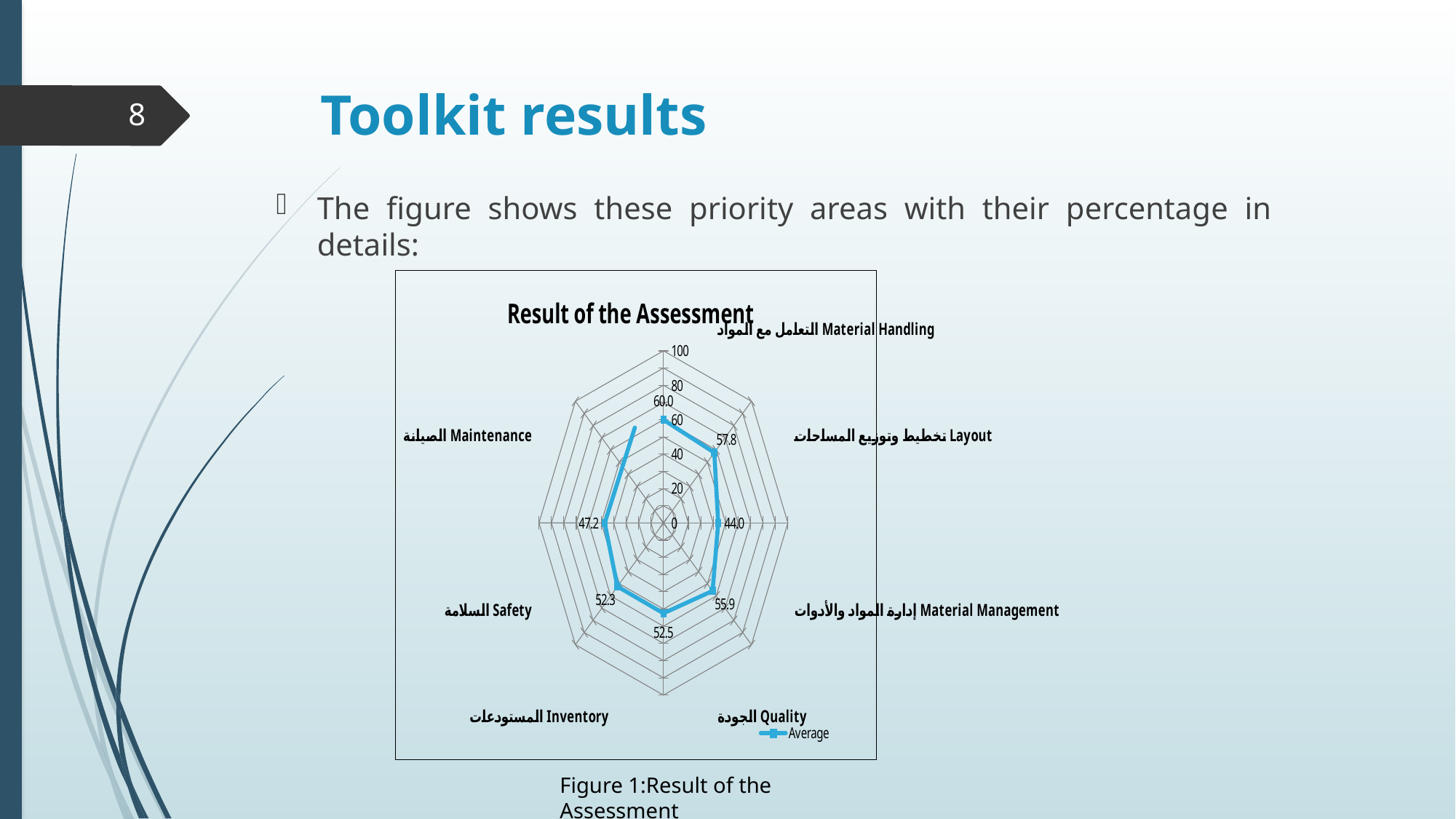
What is the value for Layout? 57.8 What kind of chart is shown on the slide? radar chart What is the difference between the values for Material Handling and Layout? 2.2 Is the value for Material Handling greater or less than 40? greater Which is larger, the value for Material Handling or the value for Material Management? Material Handling What is the value for Material Management? 44.0 What is the value for Material Handling? 60.0 What is the highest value printed on the chart? 60.0 How many series does the chart legend list? 1 What is the name of the series shown in the legend? Average What is the lowest value printed on the chart? 44.0 What is the title of the chart? Result of the Assessment